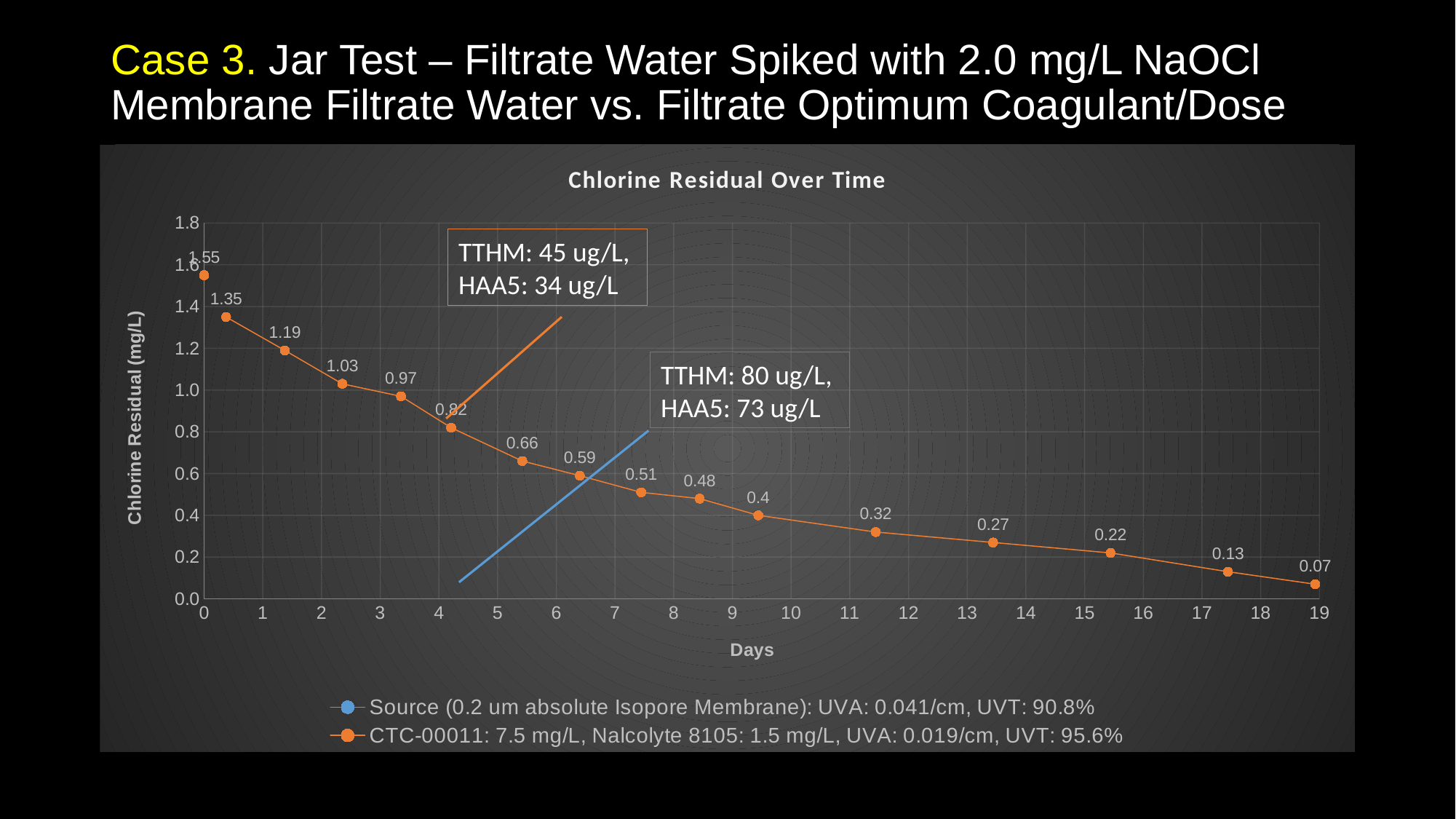
What is the lowest chlorine residual value plotted on the chart? 0.07 How many data points are plotted on the orange CTC-00011 line? 16 What is the title of the chart? Chlorine Residual Over Time What is the chlorine residual value of the first data point, at day 0? 1.55 What is the value of the fourth data point on the orange line? 1.03 What is the label of the vertical axis? Chlorine Residual (mg/L) What is the difference between the first data point (1.55) and the last data point (0.07)? 1.48 Does the chlorine residual rise or fall as the number of days increases? fall What is the highest chlorine residual value plotted on the chart? 1.55 What is the chlorine residual value of the last data point on the line, near day 19? 0.07 What kind of chart is shown on the slide? line chart How many series does the chart legend list? 2